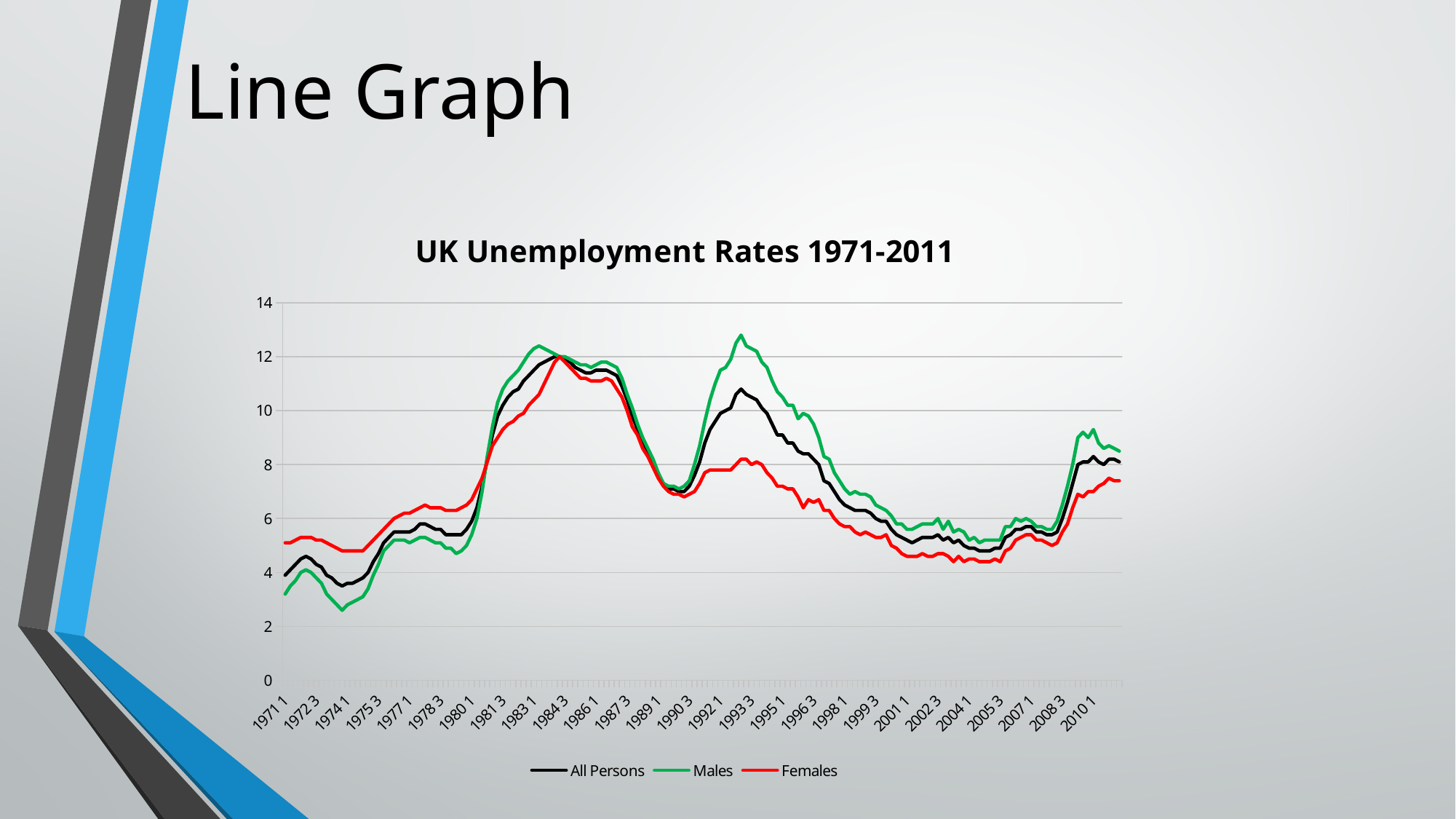
Is the value for Females at 1993 3 greater or less than 10? less Which colour is used for the Females series? red At 1993 3, which series is higher, Males or Females? Males How many series does the legend list? 3 Is the value for Males at 1974 1 greater or less than 4? less Does the All Persons series rise or fall between 1984 3 and 1990 3? fall Is the value for Females at 2004 1 greater or less than 6? less What kind of chart is shown on the slide? line chart Which series reaches the highest value anywhere on the chart? Males What is the title of the chart? UK Unemployment Rates 1971-2011 At 1978 3, which series is higher, Males or Females? Females